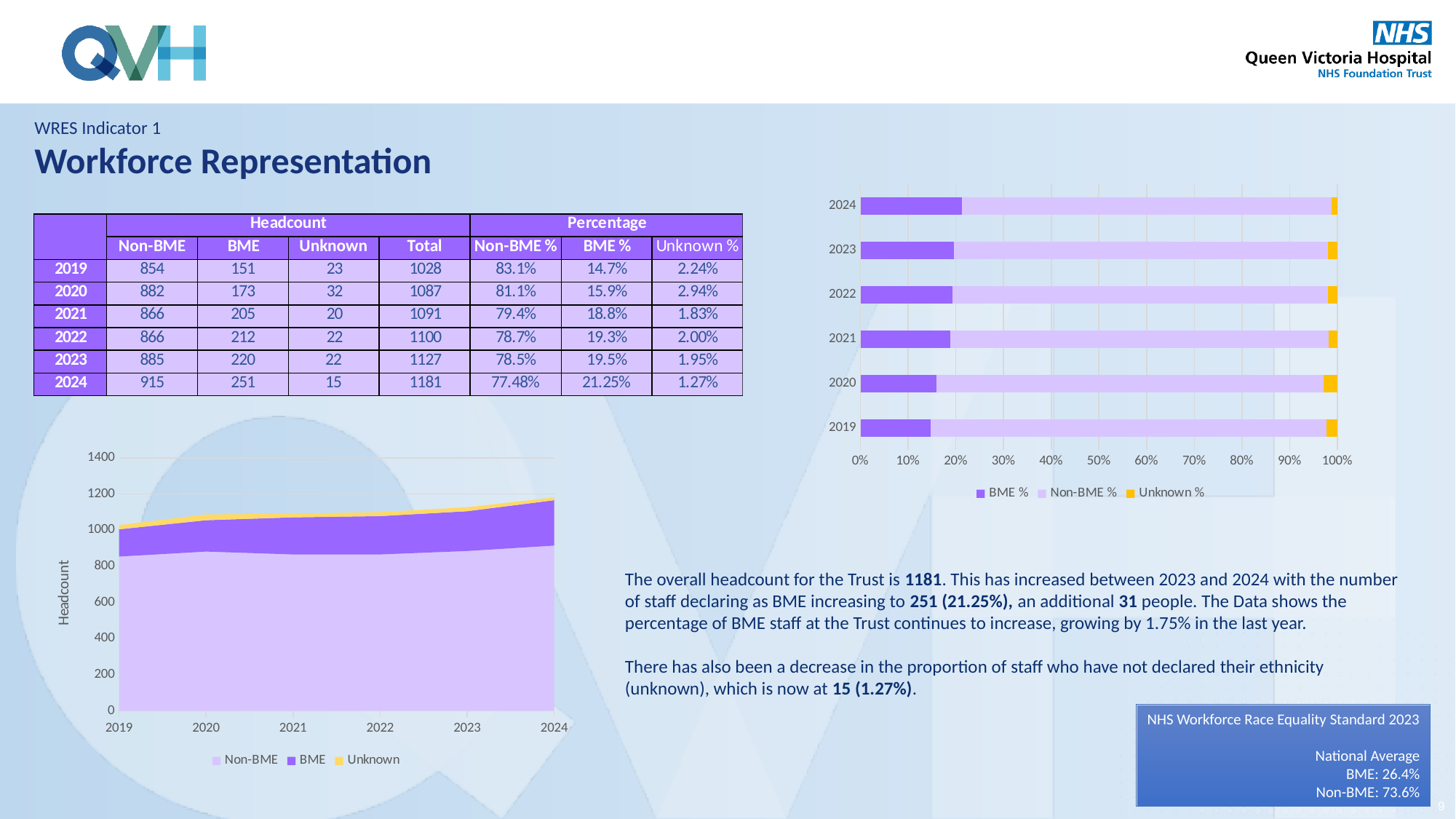
What kind of chart is the top-right chart showing percentages by year? Bar chart In the bottom-left headcount chart, is the total headcount for 2024 greater or less than 1000? greater In the bottom-left headcount chart, how many series does the legend list? 3 In the bottom-left headcount chart, which colour represents the Unknown series? Yellow In the top-right percentage chart, is the BME % value for 2019 greater or less than 20%? less In the top-right percentage chart, which year has the lowest BME %? 2019 In the top-right percentage chart, which year has the highest BME %? 2024 In the bottom-left headcount chart, how many years are shown on the x axis? 6 What kind of chart is the bottom-left chart showing headcount by year? Area chart In the top-right percentage chart, how many series does the legend list? 3 In the bottom-left headcount chart, does the total headcount rise or fall from 2019 to 2024? Rises In the top-right percentage chart, is the BME % larger in 2024 or in 2020? 2024